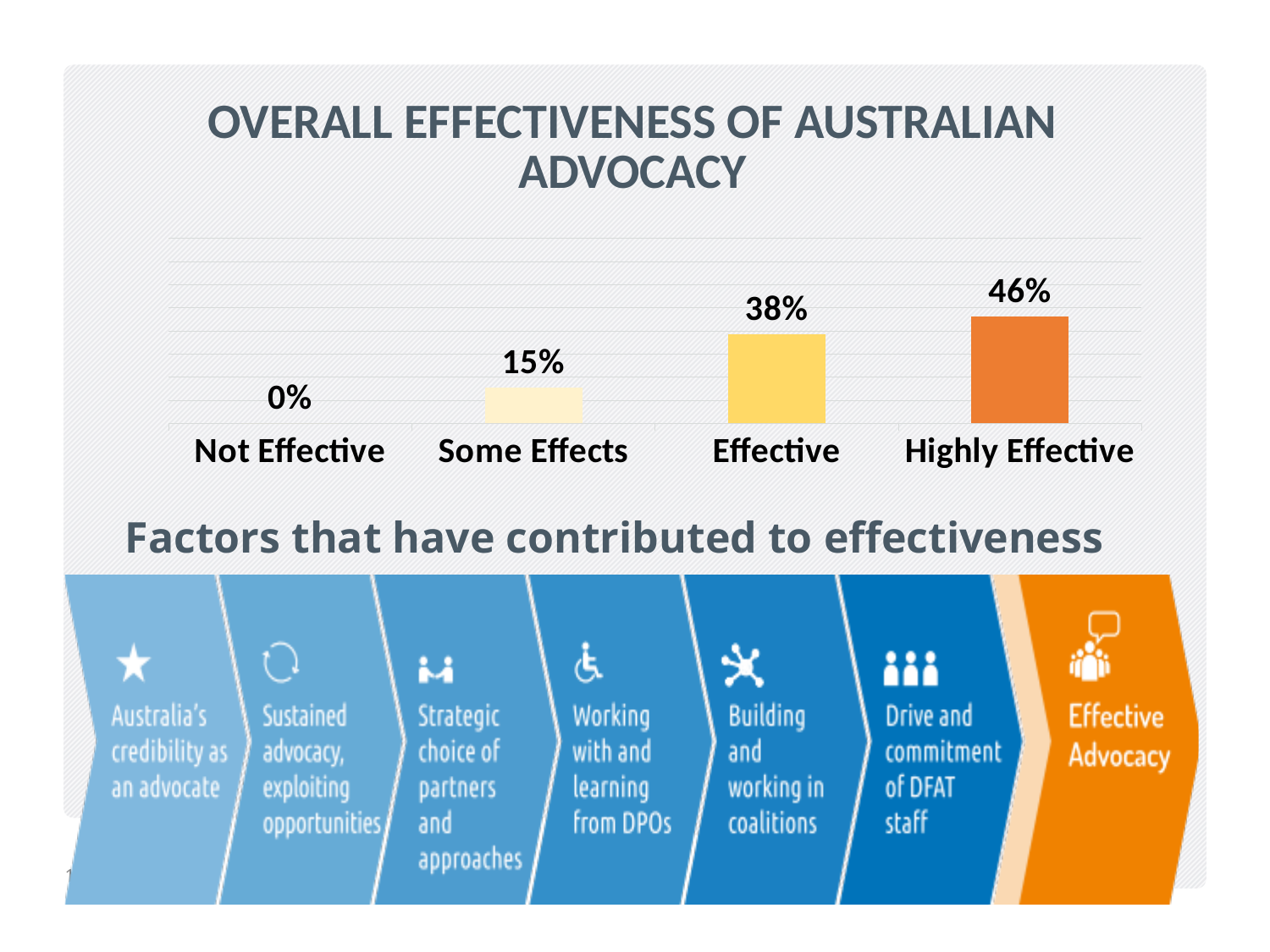
What is the value for Not Effective? 0% How many categories are shown on the chart? 4 What is the value for Highly Effective? 46% Which category has the highest value? Highly Effective What is the difference between the values for Highly Effective and Effective? 8% Do the values rise or fall from Not Effective to Highly Effective? Rise Which is larger, the value for Some Effects or the value for Effective? Effective What kind of chart is shown on the slide? Bar chart What is the difference between the values for Effective and Some Effects? 23% What is the value for Effective? 38% What is the value for Some Effects? 15% Which category has the lowest value? Not Effective